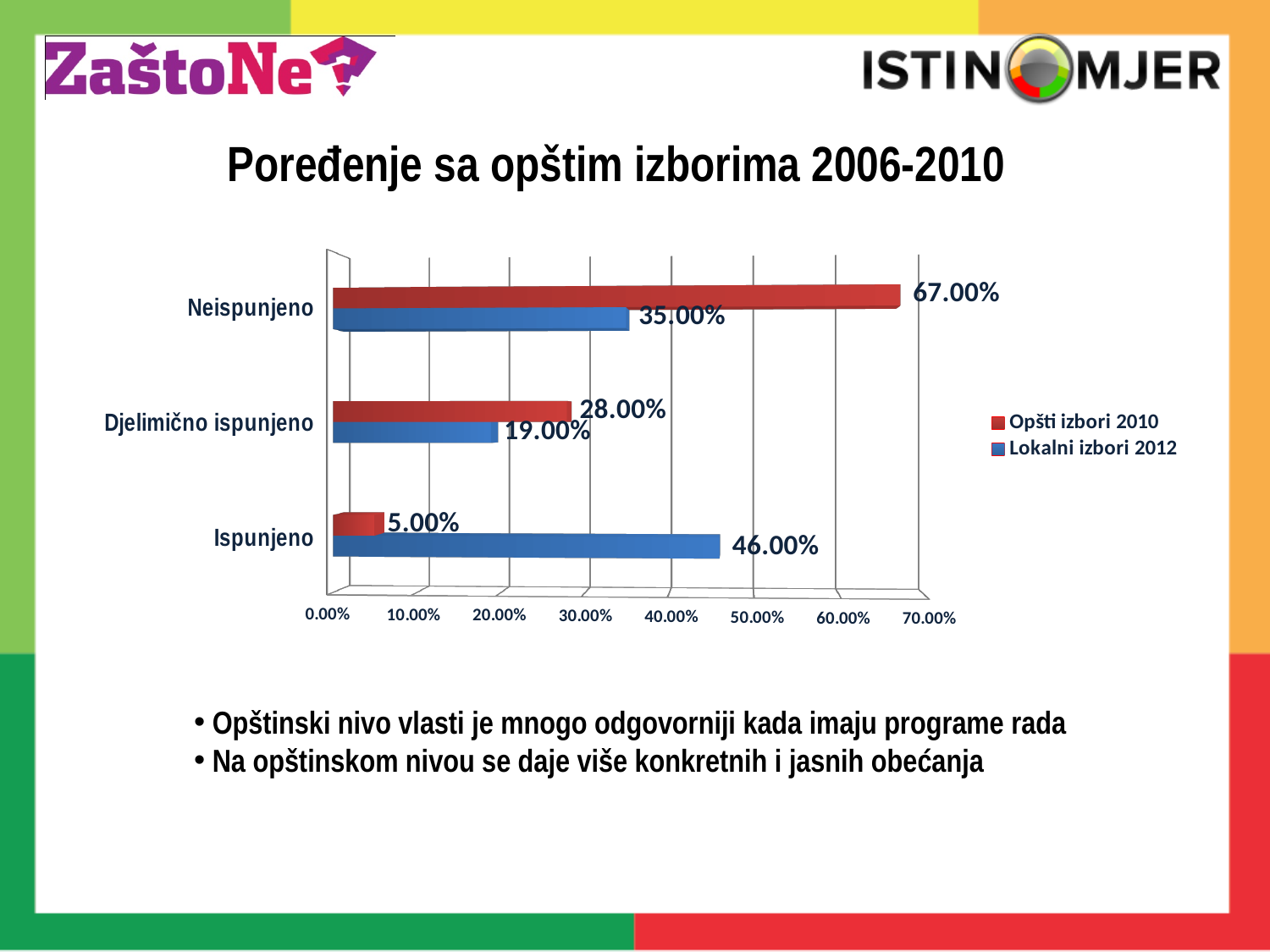
What is the difference between the Opšti izbori 2010 and Lokalni izbori 2012 values for Neispunjeno? 32.00% How many categories are shown on the chart? 3 Which category has the lowest value in the Opšti izbori 2010 series? Ispunjeno Which category has the lowest value in the Lokalni izbori 2012 series? Djelimično ispunjeno What is the value for Djelimično ispunjeno in the Lokalni izbori 2012 series? 19.00% What is the value for Ispunjeno in the Lokalni izbori 2012 series? 46.00% Which category has the highest value in the Opšti izbori 2010 series? Neispunjeno What is the value for Neispunjeno in the Opšti izbori 2010 series? 67.00% What type of chart is shown on the slide? Bar chart How many series does the legend list? 2 What is the value for Djelimično ispunjeno in the Opšti izbori 2010 series? 28.00% Which is larger for Ispunjeno: Opšti izbori 2010 or Lokalni izbori 2012? Lokalni izbori 2012